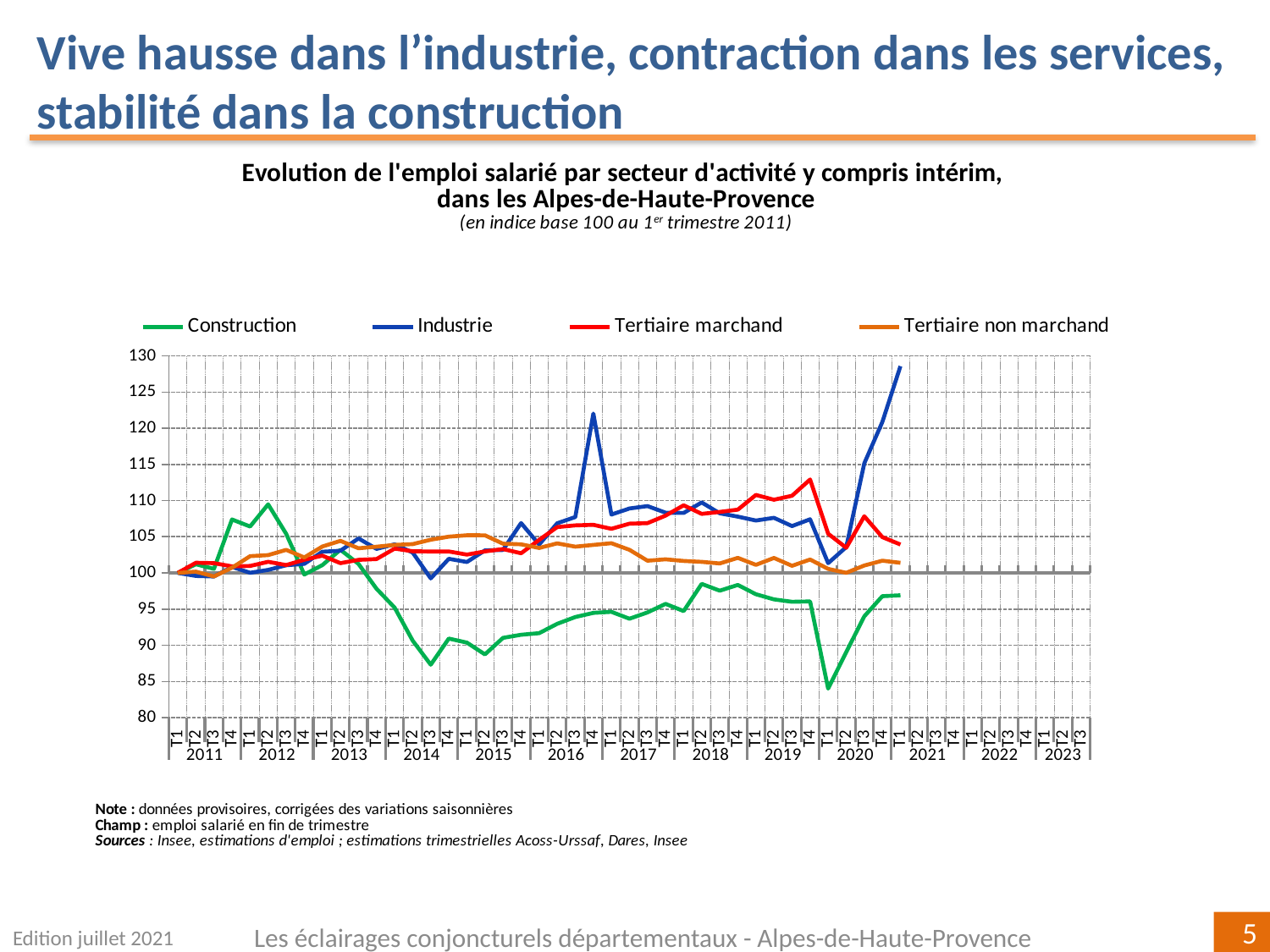
What is the index value of all series at T1 2011, the base quarter? 100 Is the value for Construction at T1 2020 greater or less than 85? less Is the value for Industrie at T4 2016 greater or less than 120? greater Which series has the highest value at T1 2021? Industrie What kind of chart is shown on the slide? line chart Which series is shown in green in the legend? Construction How many series does the legend list? 4 Is the value for Construction at T3 2014 greater or less than 90? less Which series has the lowest value at T1 2020? Construction Does the Industrie series rise or fall between T4 2020 and T1 2021? rise